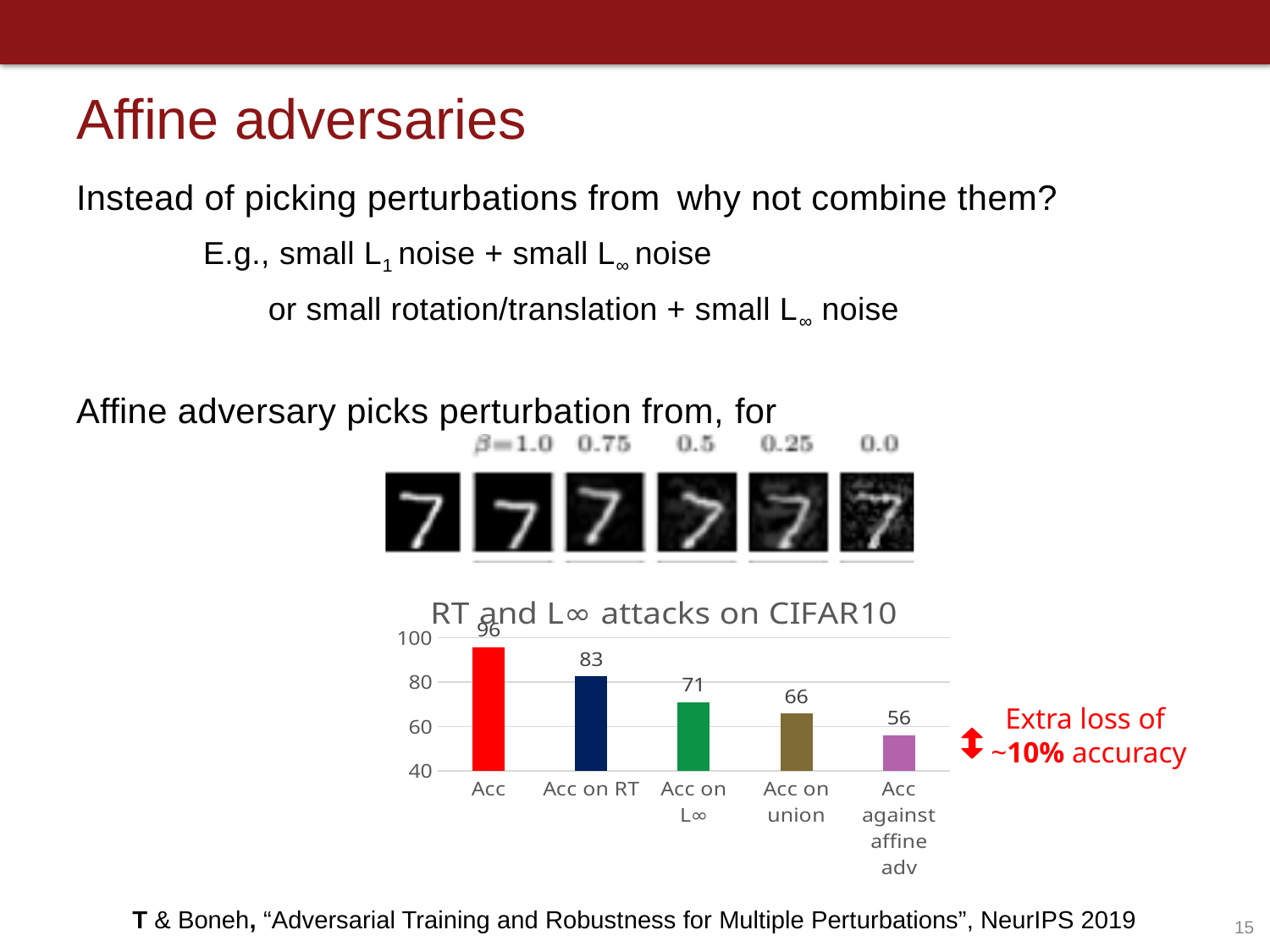
Which is larger, Acc on RT or Acc on L∞? Acc on RT Which category has the lowest value? Acc against affine adv What is the value for Acc on union? 66 What type of chart is shown on the slide? bar chart What is the value for Acc against affine adv? 56 What is the difference between Acc on union and Acc against affine adv? 10 How many categories are shown in the chart? 5 Which category has the highest value? Acc What is the value for Acc on RT? 83 What is the value for Acc on L∞? 71 What is the value for Acc? 96 What is the title of the chart? RT and L∞ attacks on CIFAR10